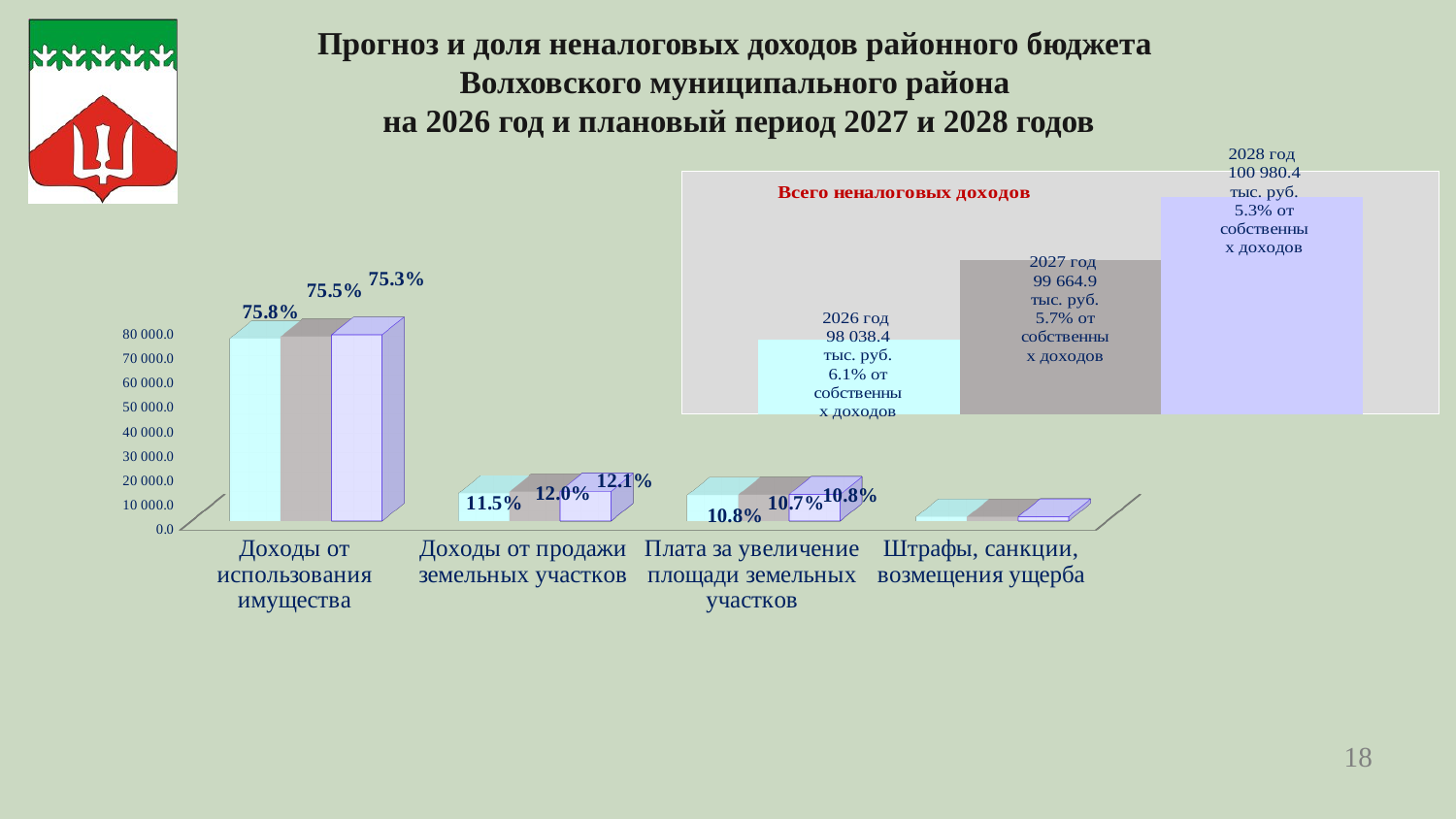
In the chart titled 'Всего неналоговых доходов', what is the difference between the 2028 value (100 980.4) and the 2026 value (98 038.4)? 2 942.0 тыс. руб. In the chart titled 'Всего неналоговых доходов', what share of own revenues is shown for 2028 год? 5.3% от собственных доходов In the left bar chart, is the value for 'Штрафы, санкции, возмещения ущерба' greater or less than 10 000.0? less What kind of chart is the left chart with categories such as 'Доходы от использования имущества'? bar chart In the left bar chart, what is the data label on the first (leftmost) bar for 'Доходы от использования имущества'? 75.8% How many categories are shown on the x axis of the left bar chart? 4 In the left bar chart, which is larger: the first bar for 'Доходы от использования имущества' (75.8%) or the first bar for 'Доходы от продажи земельных участков' (11.5%)? Доходы от использования имущества In the chart titled 'Всего неналоговых доходов', do the values rise or fall from 2026 to 2028? rise In the chart titled 'Всего неналоговых доходов', what is the value for 2027 год? 99 664.9 тыс. руб. In the chart titled 'Всего неналоговых доходов', which year has the highest value? 2028 год How many bars are shown in the chart titled 'Всего неналоговых доходов'? 3 In the left bar chart, what is the data label on the third bar for 'Доходы от продажи земельных участков'? 12.1%